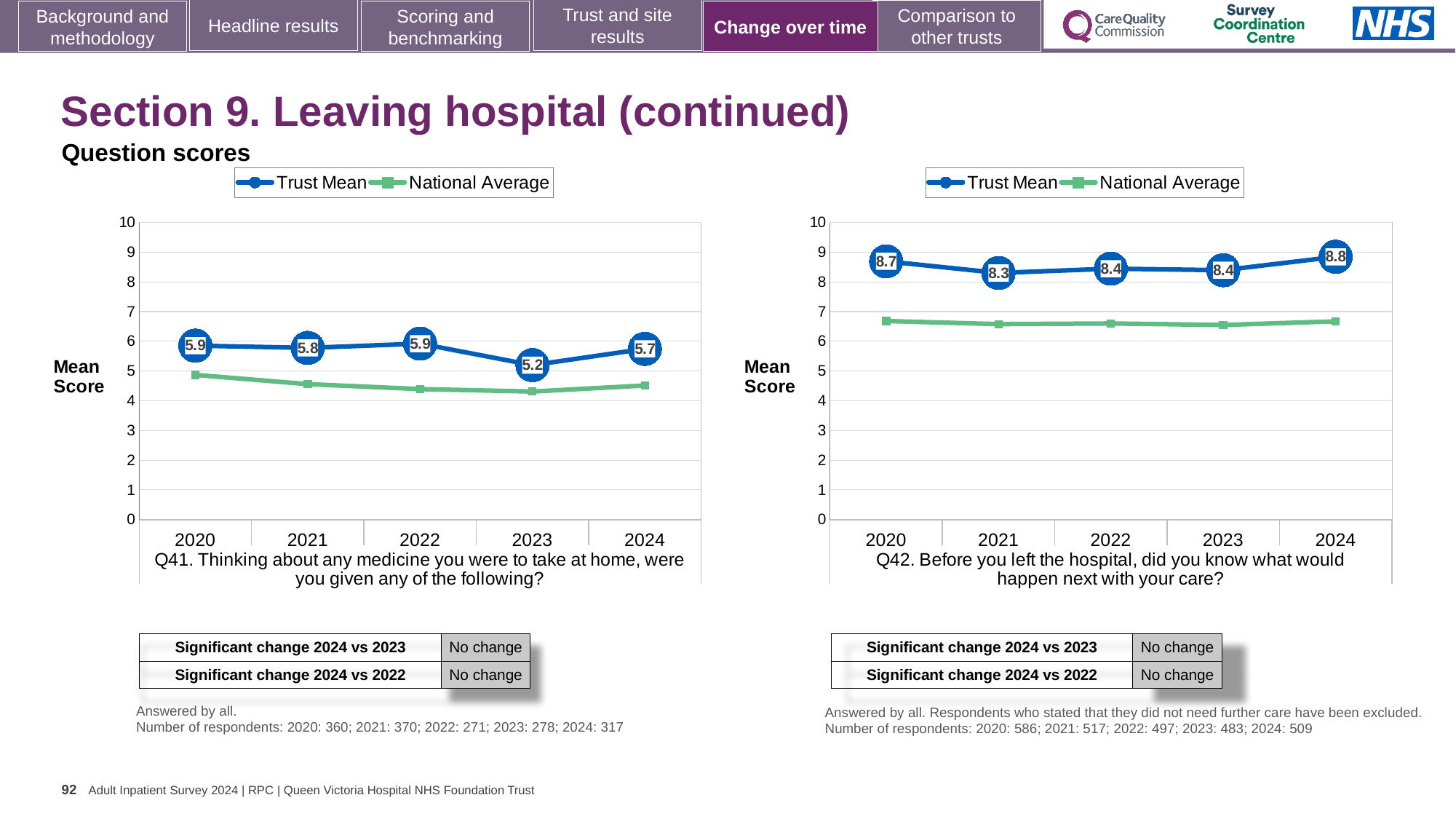
What type of chart is used for Q42 (right)? Line chart In the Q42 chart (right), what is the Trust Mean value for 2024? 8.8 In the Q41 chart (left), is the National Average for 2020 greater or less than 5? less In the Q42 chart (right), what is the difference between the Trust Mean in 2024 and in 2023? 0.4 In the Q41 chart (left), which year has the lowest Trust Mean? 2023 In the Q42 chart (right), is the National Average for 2024 greater or less than 7? less In the Q41 chart (left), what is the Trust Mean value for 2023? 5.2 In the Q42 chart (right), which year has the highest Trust Mean? 2024 How many years are plotted on the x axis of the Q42 chart (right)? 5 How many series does the legend of the Q41 chart (left) list? 2 In the Q41 chart (left), is the Trust Mean higher in 2020 or in 2023? 2020 In the Q41 chart (left), what is the difference between the Trust Mean in 2022 and in 2023? 0.7